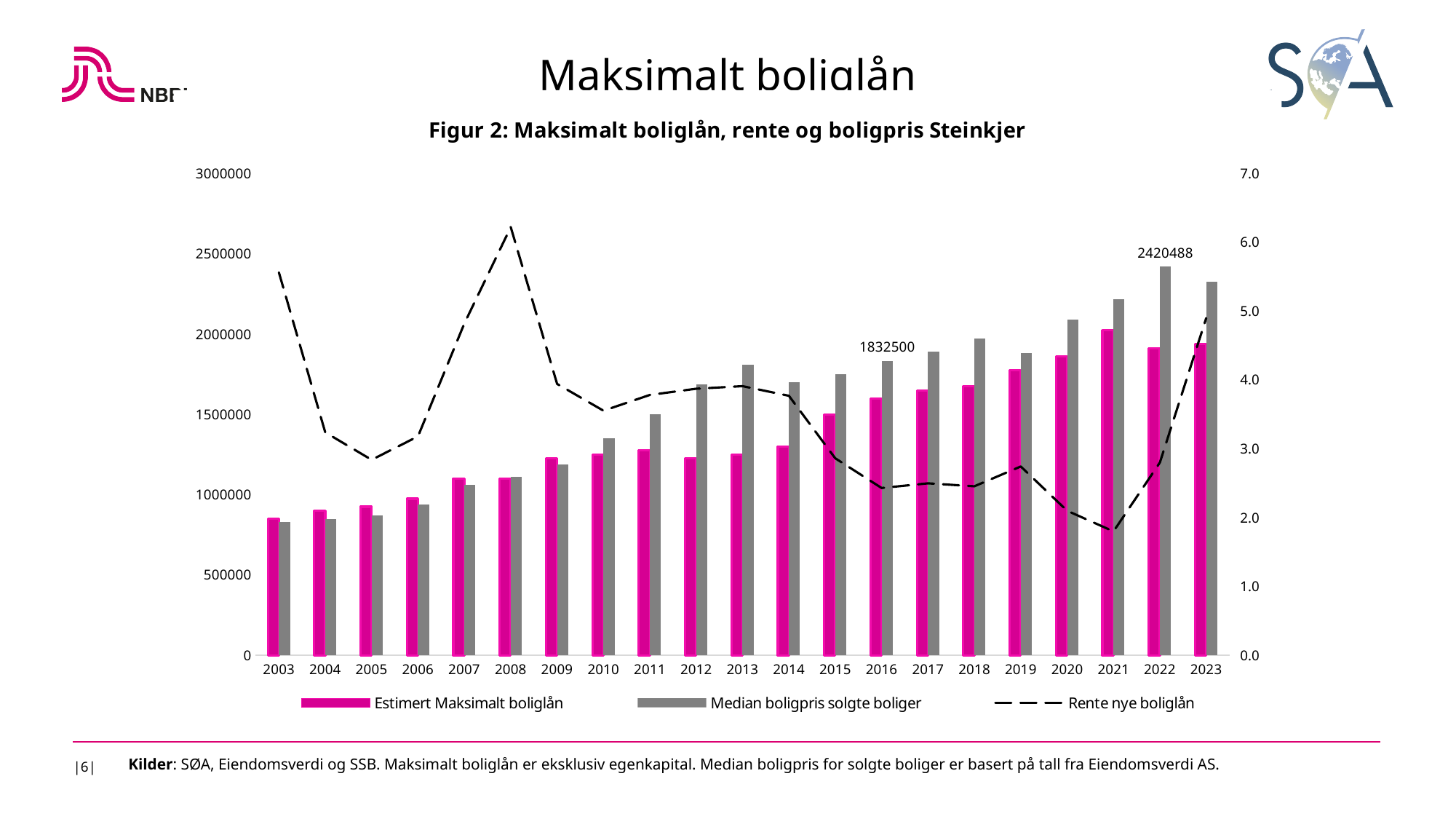
What is the value of Median boligpris solgte boliger in 2016? 1832500 In which year is Median boligpris solgte boliger highest? 2022 How many years are shown on the x axis? 21 What kind of chart is shown? Bar chart with a line In which year does Rente nye boliglån reach its highest point? 2008 In which year is Rente nye boliglån at its lowest? 2021 What is the value of Median boligpris solgte boliger in 2022? 2420488 What is the difference between the Median boligpris solgte boliger values labelled for 2022 and 2016? 587988 In 2021, which is larger: Estimert Maksimalt boliglån or Median boligpris solgte boliger? Median boligpris solgte boliger How many series does the legend list? 3 What is the title of the figure? Figur 2: Maksimalt boliglån, rente og boligpris Steinkjer Is the value of Median boligpris solgte boliger in 2023 greater or less than 2000000? greater